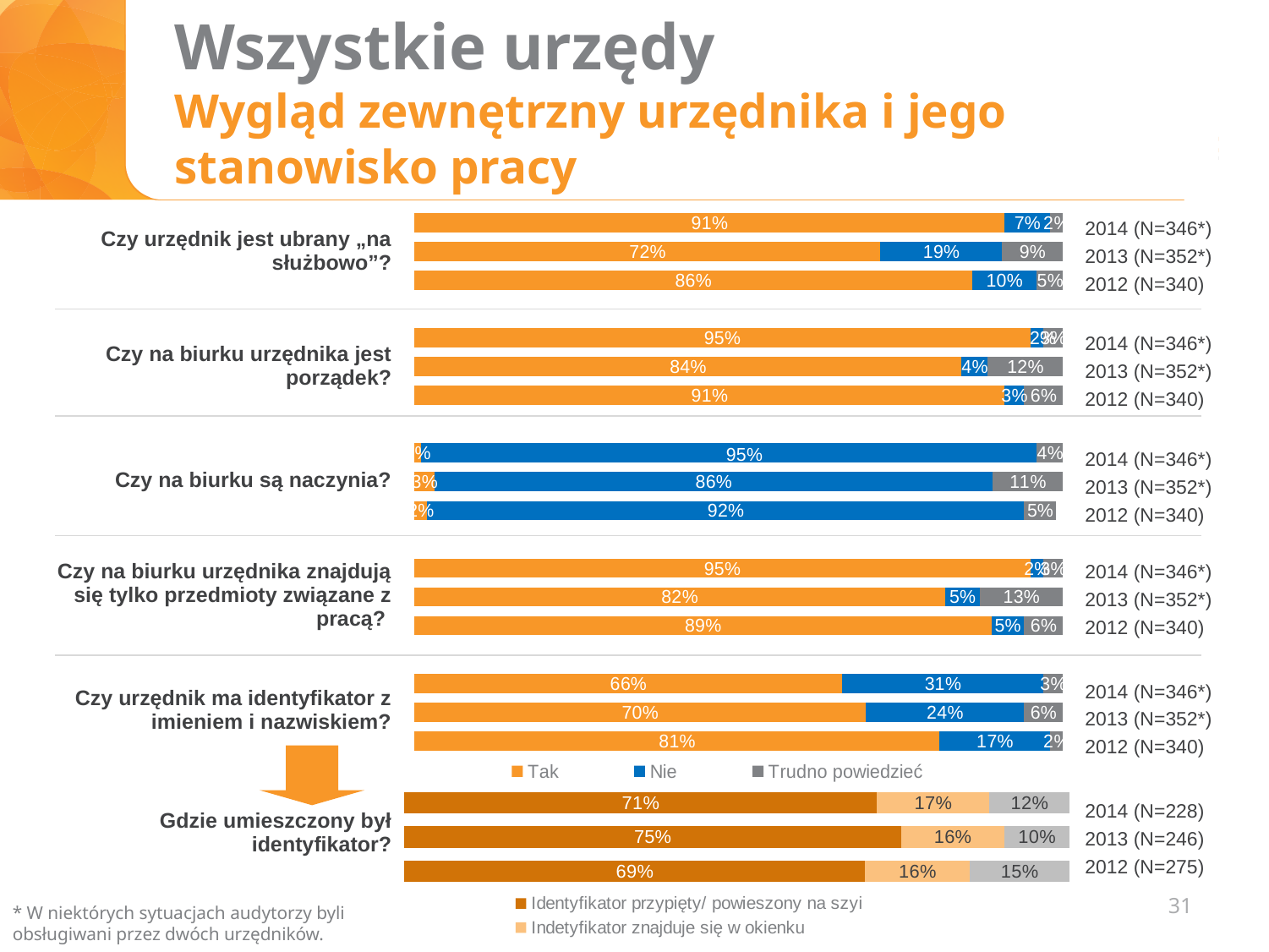
In the lower chart "Gdzie umieszczony był identyfikator?", what percentage is shown for "Indetyfikator znajduje się w okienku" in 2014 (N=228)? 17% In the upper chart, for "Czy na biurku urzędnika znajdują się tylko przedmioty związane z pracą?", which year has the larger "Trudno powiedzieć" share: 2013 or 2012? 2013 (N=352*) In the upper chart, for "Czy urzędnik ma identyfikator z imieniem i nazwiskiem?", in which year was the "Tak" share highest? 2012 (N=340) What type of chart is used on this slide? Stacked bar chart How many series does the legend of the upper chart list? 3 In the upper chart, what percentage answered "Nie" to "Czy na biurku są naczynia?" in 2012 (N=340)? 92% In the upper chart, what percentage answered "Tak" to "Czy urzędnik jest ubrany „na służbowo”?" in 2014 (N=346*)? 91% In the upper chart, what percentage answered "Trudno powiedzieć" to "Czy na biurku urzędnika jest porządek?" in 2013 (N=352*)? 12% In the lower chart "Gdzie umieszczony był identyfikator?", what percentage is shown for "Identyfikator przypięty/ powieszony na szyi" in 2013 (N=246)? 75% In the upper chart, what percentage answered "Nie" to "Czy urzędnik ma identyfikator z imieniem i nazwiskiem?" in 2014 (N=346*)? 31% In the upper chart, what percentage answered "Nie" to "Czy urzędnik jest ubrany „na służbowo”?" in 2013 (N=352*)? 19% In the upper chart, for "Czy urzędnik jest ubrany „na służbowo”?", what is the difference between the "Tak" share in 2014 and in 2013? 19 percentage points